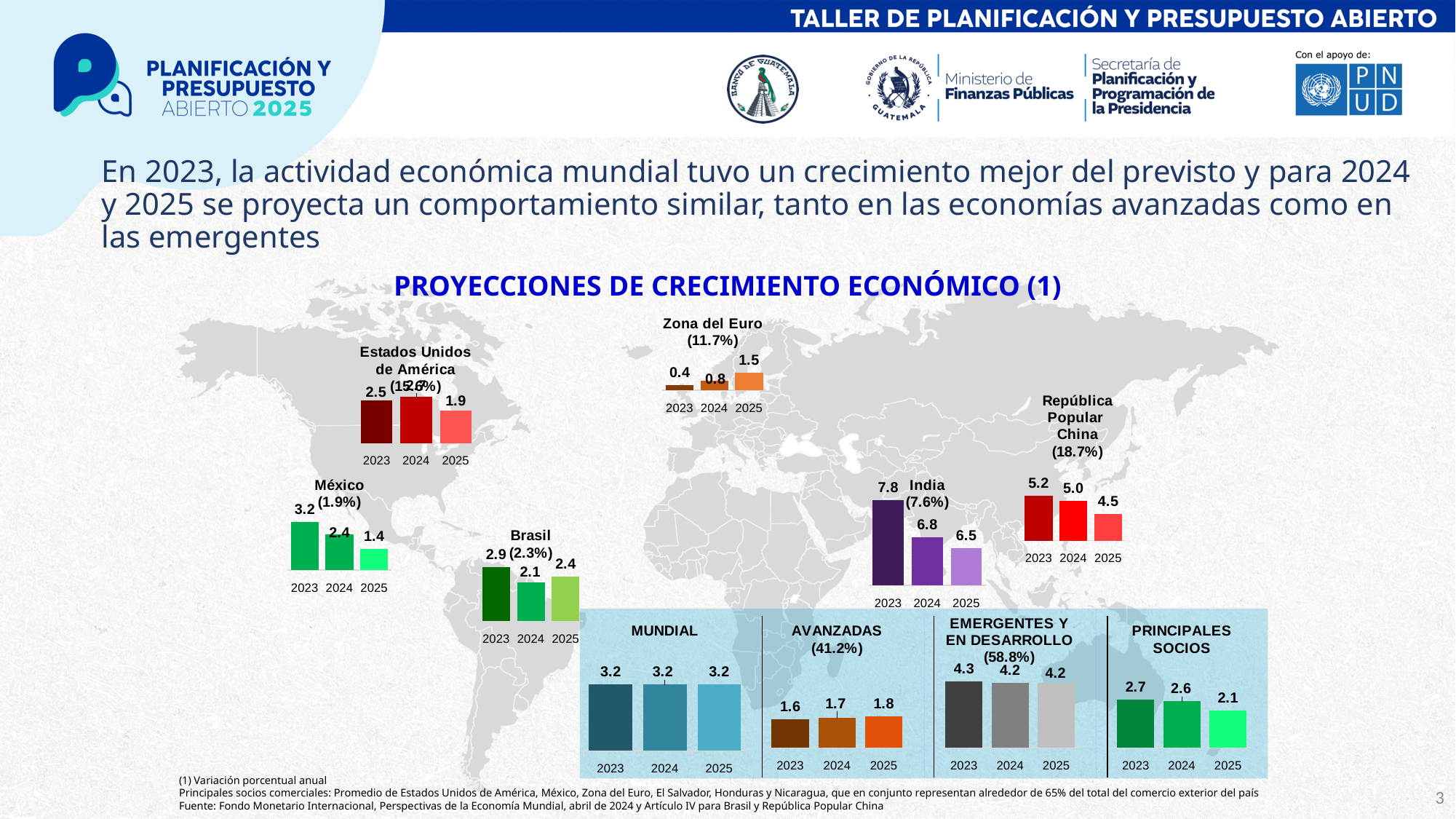
In the Principales Socios chart, which is larger, the value for 2023 or the value for 2025? 2023 In the India chart, what is the difference between the 2023 and 2025 values? 1.3 What is the title of the section containing the charts? PROYECCIONES DE CRECIMIENTO ECONÓMICO (1) In the Avanzadas chart, do the values rise or fall from 2023 to 2025? Rise In the México chart, which year has the highest value? 2023 In the Mundial chart, how many years are plotted? 3 In the India chart, what is the value for 2023? 7.8 In the Emergentes y en Desarrollo chart, what is the value for 2023? 4.3 In the República Popular China chart, what is the value for 2024? 5.0 What kind of chart is used for the Avanzadas data? Bar chart In the Zona del Euro chart, what is the value for 2025? 1.5 In the Brasil chart, which year has the lowest value? 2024